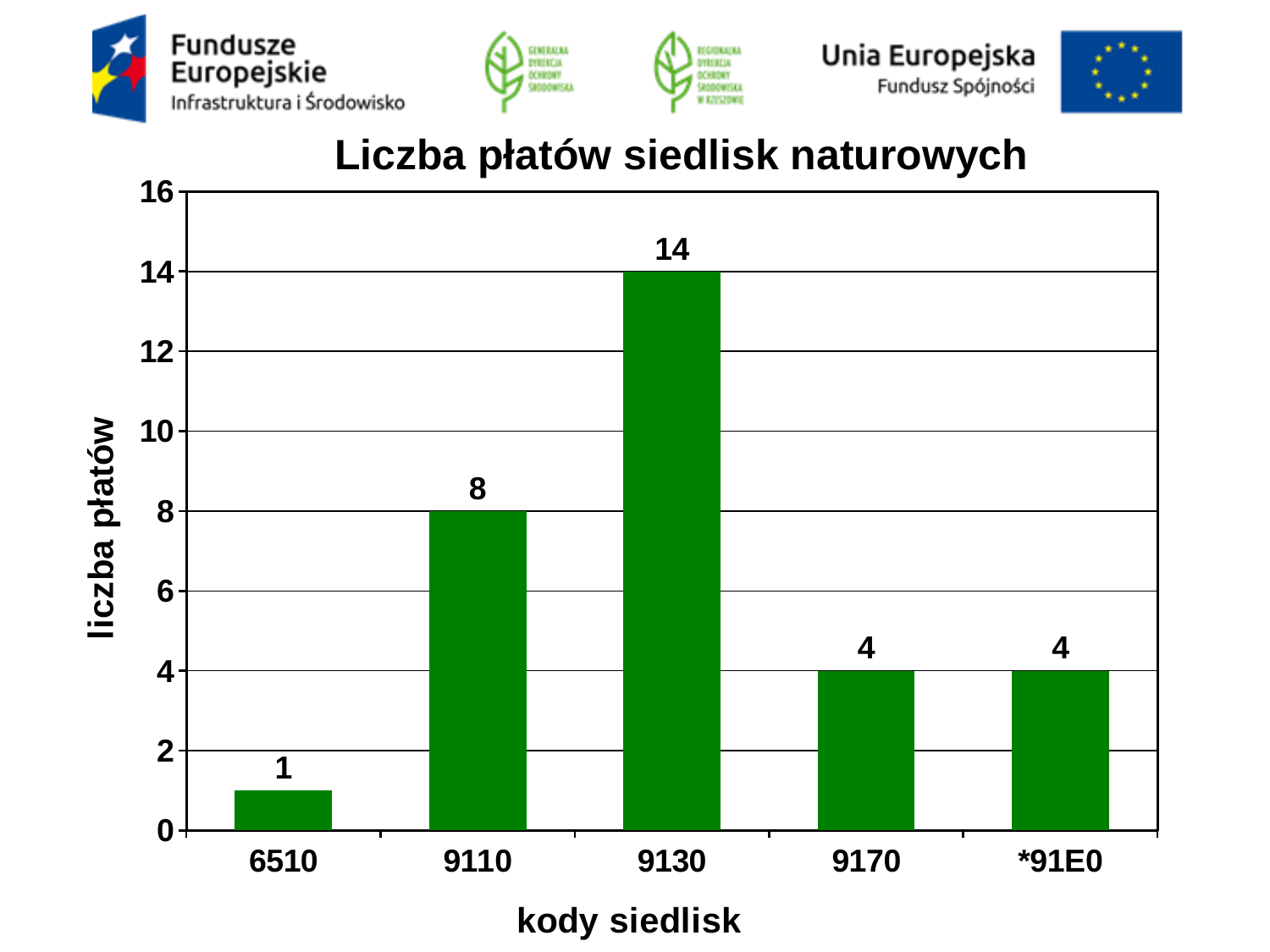
Which is larger, the value for 9110 or the value for 9170? 9110 How many habitat codes are shown on the x axis? 5 What is the value for habitat code 9110? 8 Is the value for 9130 greater or less than 12? greater What is the value for habitat code 9130? 14 What is the difference between the values for 9130 and 9110? 6 What is the value for habitat code *91E0? 4 What kind of chart is shown on the slide? bar chart Which habitat code has the lowest number of patches? 6510 What is the title of the chart? Liczba płatów siedlisk naturowych What is the value for habitat code 6510? 1 Which habitat code has the highest number of patches? 9130